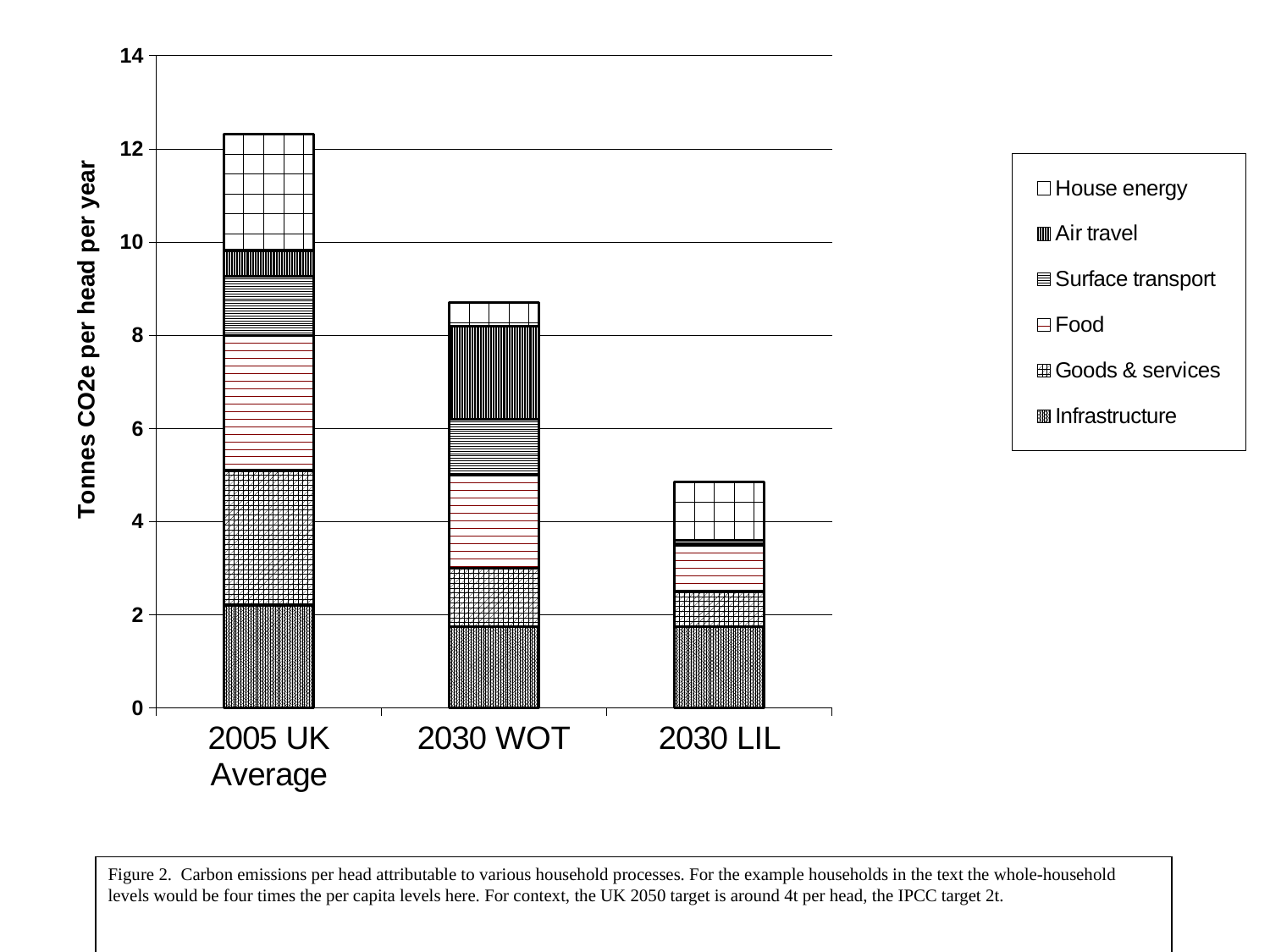
Do the total bar heights rise or fall from left to right across the x axis? fall How many series does the chart's legend list? 6 Is the total value for 2005 UK Average greater or less than 10? greater Which has the larger total bar, 2030 WOT or 2030 LIL? 2030 WOT Which series is listed first in the legend? House energy What is the title of the y axis? Tonnes CO2e per head per year Is the total value for 2030 LIL greater or less than 6? less Which category has the lowest total emissions per head? 2030 LIL What kind of chart is shown on the slide? Stacked bar chart Which category has the highest total emissions per head? 2005 UK Average How many categories are shown on the x axis of the chart? 3 Is the total value for 2030 WOT greater or less than 8? greater